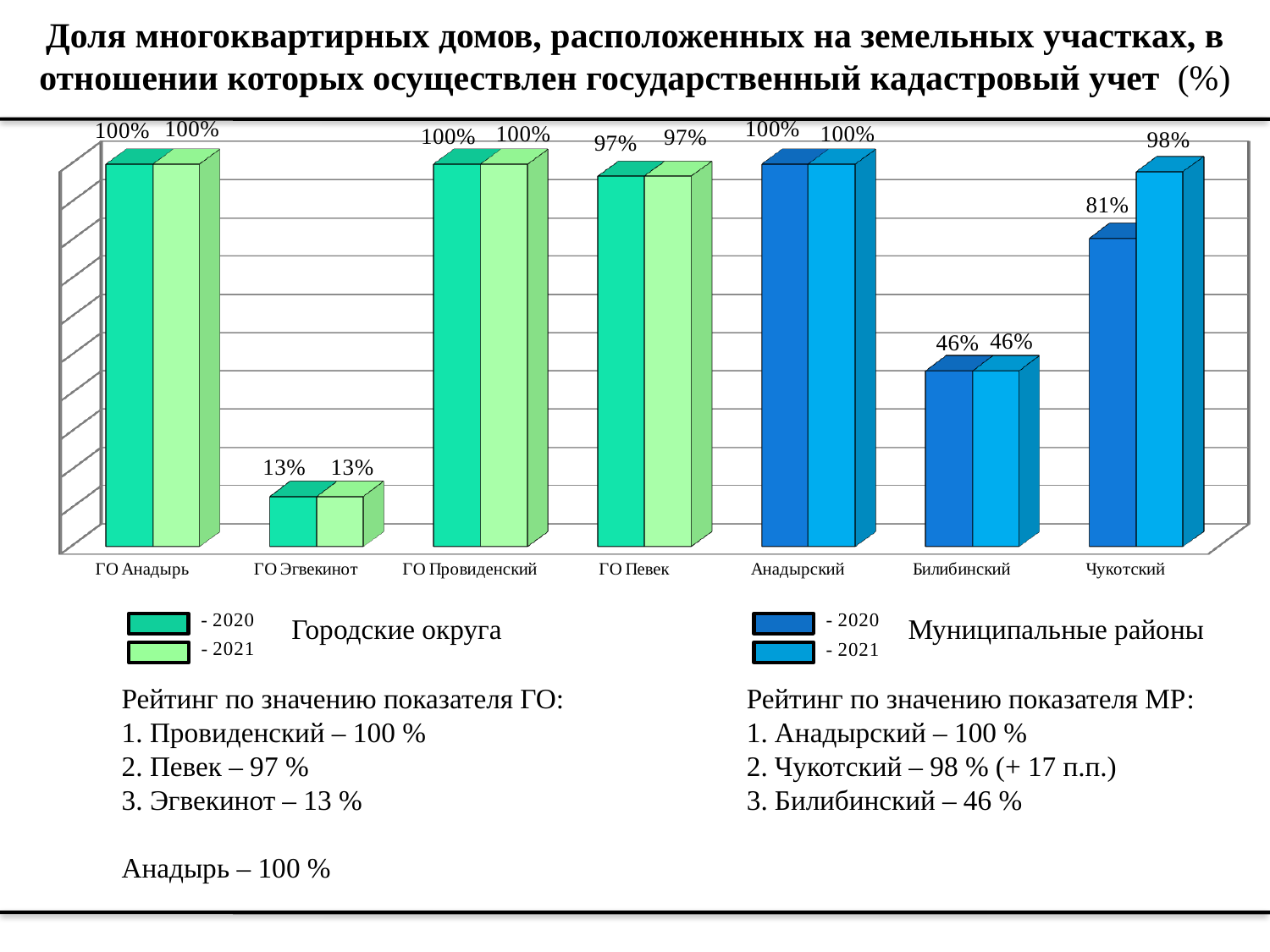
Which two years are compared in the chart's legend? 2020 and 2021 What is the difference between the 2021 values for Билибинский and ГО Эгвекинот? 33 Which is larger: the 2021 value for Билибинский or the 2021 value for Чукотский? Чукотский Which category has the lowest 2021 value? ГО Эгвекинот What kind of chart is shown on the slide? Bar chart How many categories are shown on the x axis of the chart? 7 What is the 2020 value for Билибинский? 46% By how many percentage points did the value for Чукотский change from 2020 to 2021? 17 What is the 2021 value for ГО Певек? 97% What is the 2021 value for ГО Эгвекинот? 13% What is the 2021 value for Чукотский? 98% What is the 2020 value for Чукотский? 81%